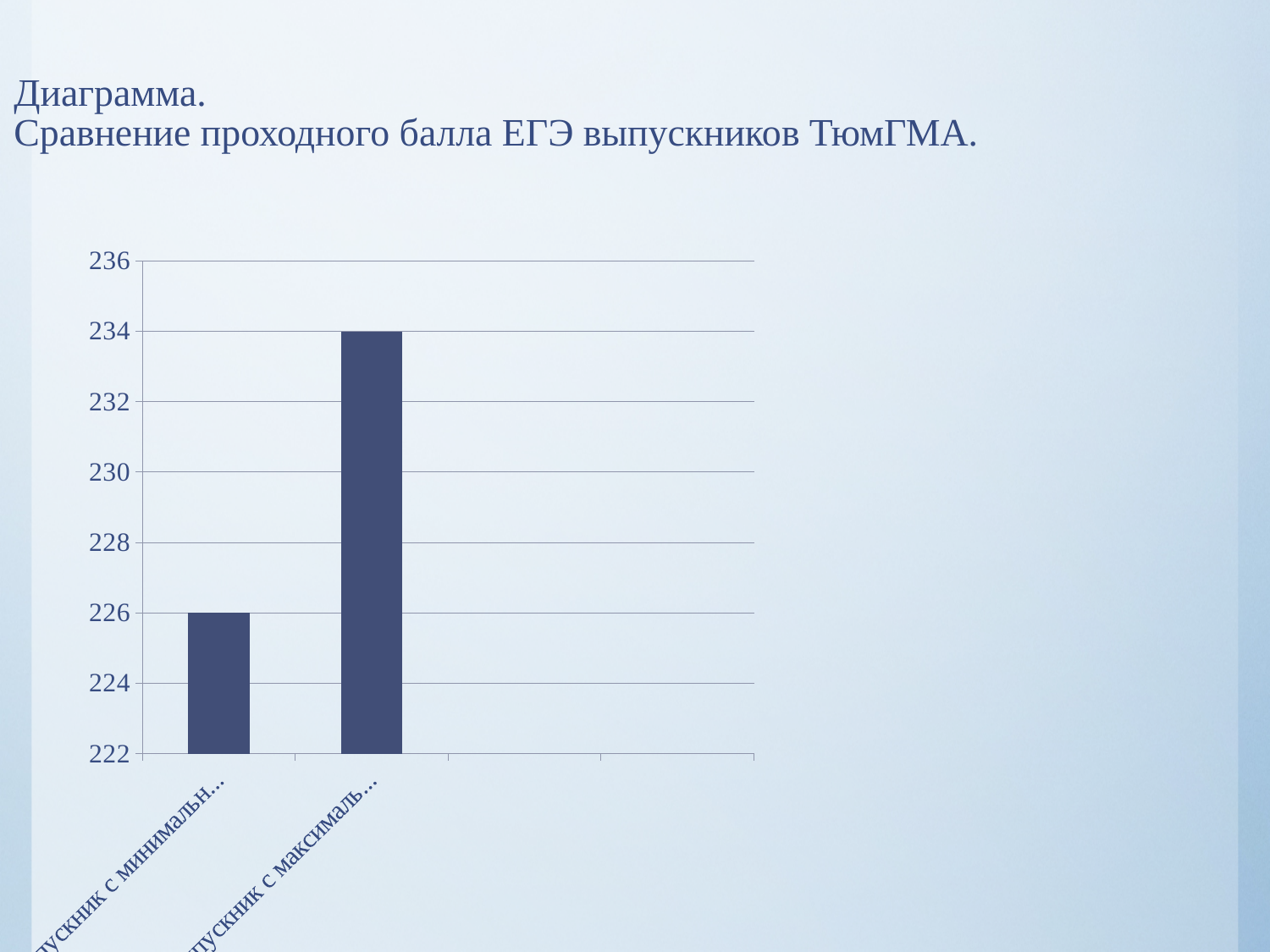
Which bar is the highest, the left one ('...с минимальн...') or the right one ('...с максималь...')? the right one ('...с максималь...') Is the value of the left bar ('...с минимальн...') greater or less than 230? less What type of chart is shown on the slide? bar chart What is the value of the left bar (the category labelled '...с минимальн...')? 226 What is the difference between the right bar (234) and the left bar (226)? 8 Which bar is the lowest, the left one ('...с минимальн...') or the right one ('...с максималь...')? the left one ('...с минимальн...') How many bars are plotted in the chart? 2 What is the highest value shown on the vertical axis? 236 Do the bar values rise or fall from left to right along the x axis? rise Is the value of the right bar ('...с максималь...') greater or less than 230? greater What is the value of the right bar (the category labelled '...с максималь...')? 234 What is the title of the slide containing the chart? Диаграмма. Сравнение проходного балла ЕГЭ выпускников ТюмГМА.